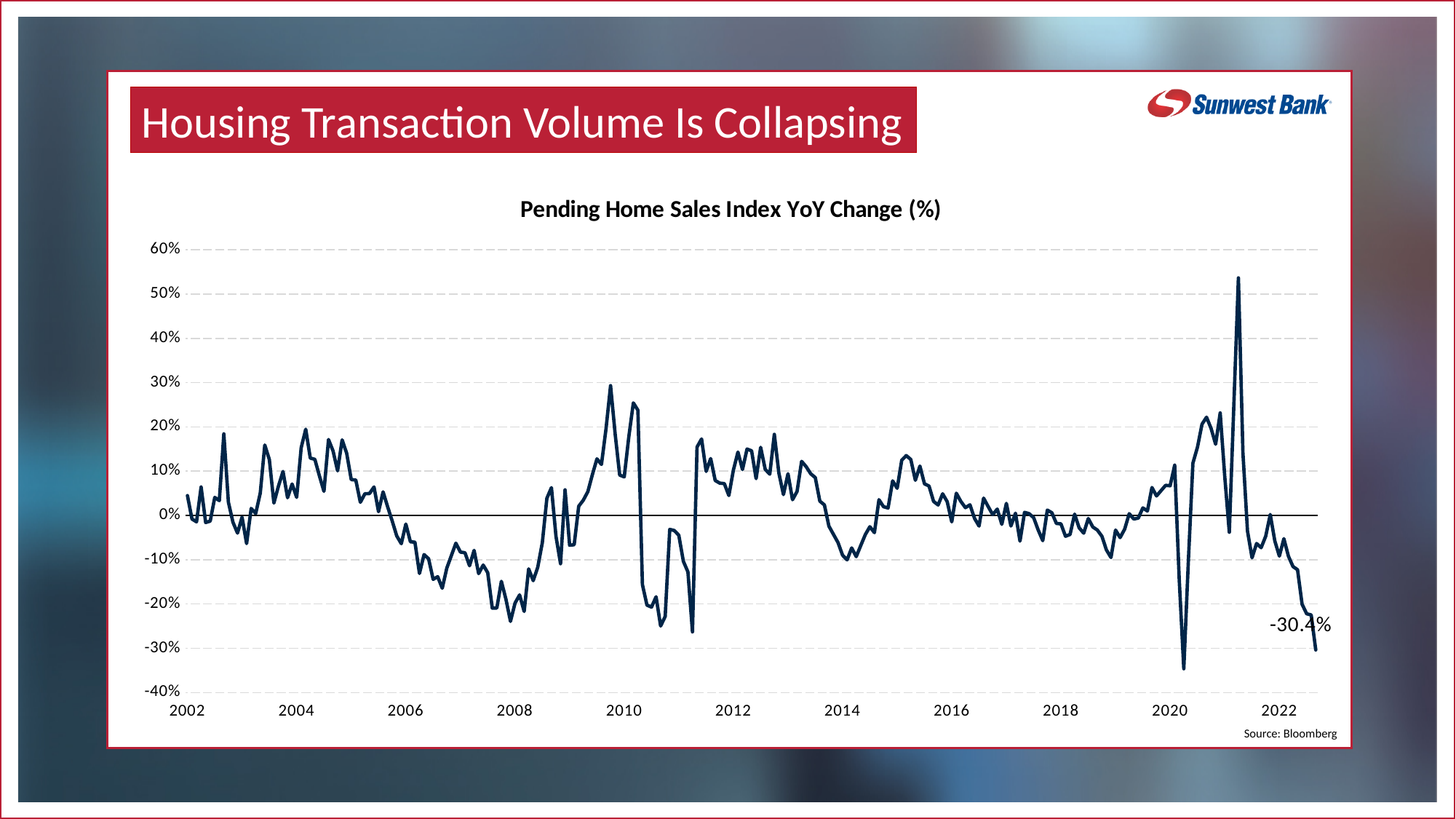
What kind of chart is shown on the slide? line chart In which year does the line reach its highest value? 2021 Is the peak value of the line in 2021 greater or less than 50%? greater Is the lowest value of the line in 2020 greater or less than -30%? less Is the value of the line at the end of 2022 greater or less than the peak value in 2021? less How many year labels are shown on the x axis? 11 Is the value of the line at the start of 2008 greater or less than -10%? less What is the title of the chart on the slide? Pending Home Sales Index YoY Change (%) Does the line rise or fall from its 2021 peak to the end of 2022? fall What is the value printed as a data label at the end of the line in 2022? -30.4% What is the source cited for the chart? Bloomberg